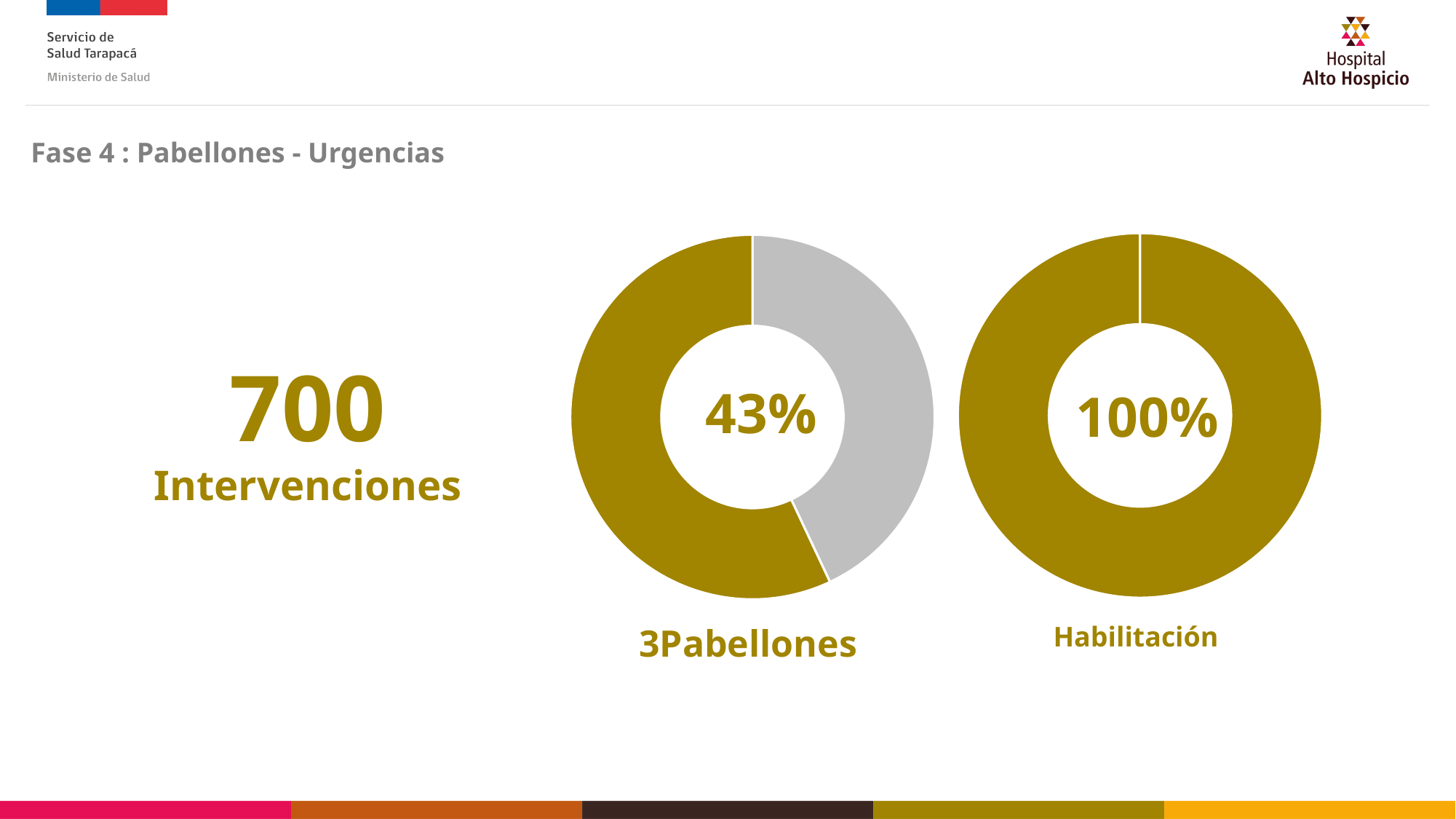
What is the title of the slide containing the donut charts? Fase 4 : Pabellones - Urgencias What colour is the filled portion of the Habilitación donut chart? Gold How many donut charts are shown on the slide? 2 What kind of chart is used for 3Pabellones and Habilitación? Donut chart What is the difference in percentage points between the Habilitación donut and the 3Pabellones donut? 57% In the 3Pabellones donut chart, what share of the ring is filled in gold? 43% In the donut chart labelled Habilitación, what percentage is shown in the centre? 100% Is the percentage shown in the 3Pabellones donut chart greater or less than 50%? less Which donut chart shows the lower percentage, 3Pabellones or Habilitación? 3Pabellones In the donut chart labelled 3Pabellones, what percentage is shown in the centre? 43% Which donut chart shows the higher percentage, 3Pabellones or Habilitación? Habilitación